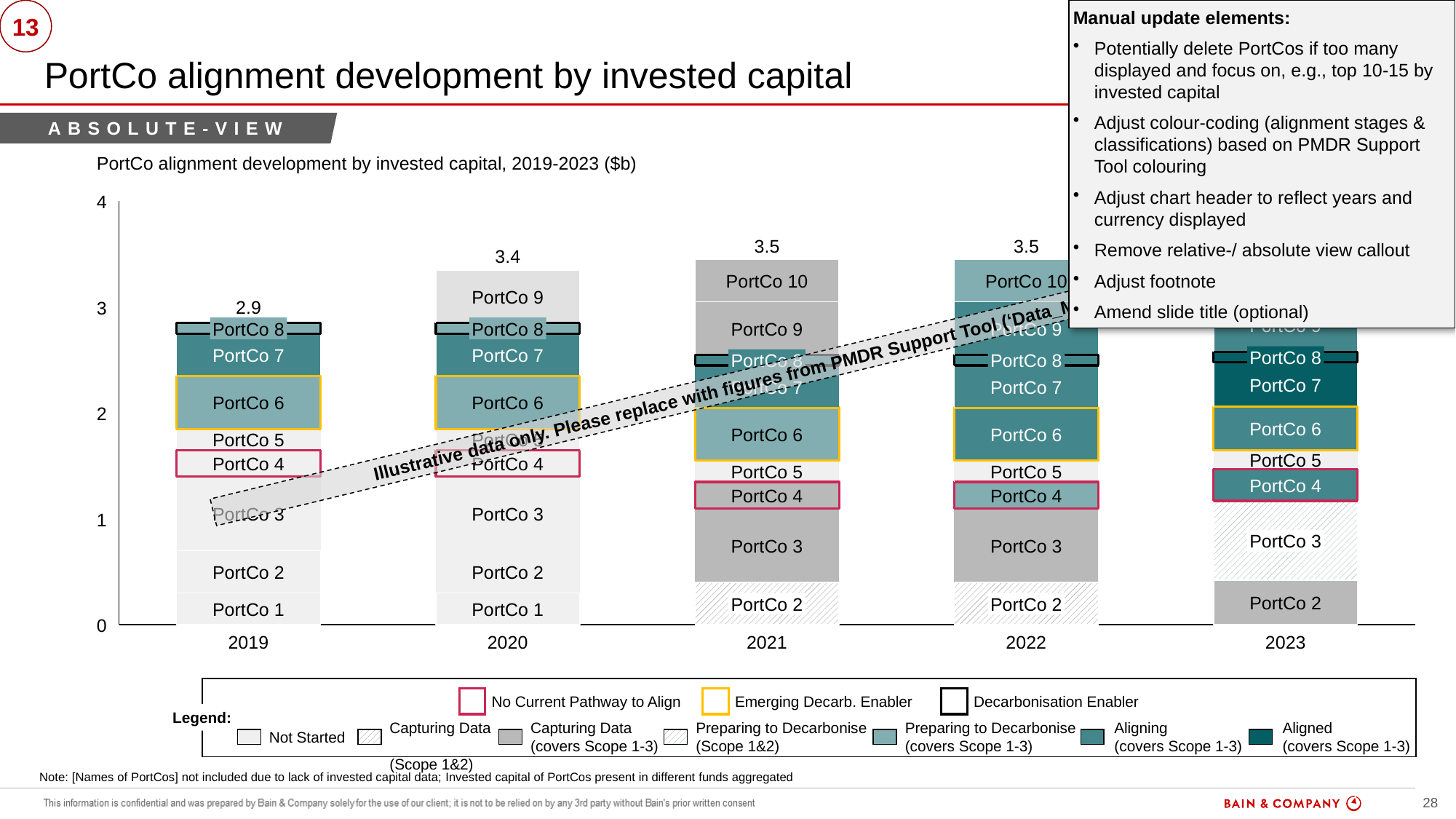
Is the total for the 2023 bar greater or less than 3? greater What is the total invested capital shown for 2021? 3.5 How many years are shown on the x axis? 5 Among the years with printed totals (2019-2022), which year has the lowest total? 2019 What does the pink outline in the legend denote? No Current Pathway to Align Which year has a larger total, 2019 or 2021? 2021 What is the total invested capital shown for 2020? 3.4 What kind of chart is shown on the slide? Stacked bar chart What is the total invested capital shown for 2022? 3.5 Do the bar totals rise or fall from 2019 to 2021? rise By how much does the total for 2020 exceed the total for 2019? 0.5